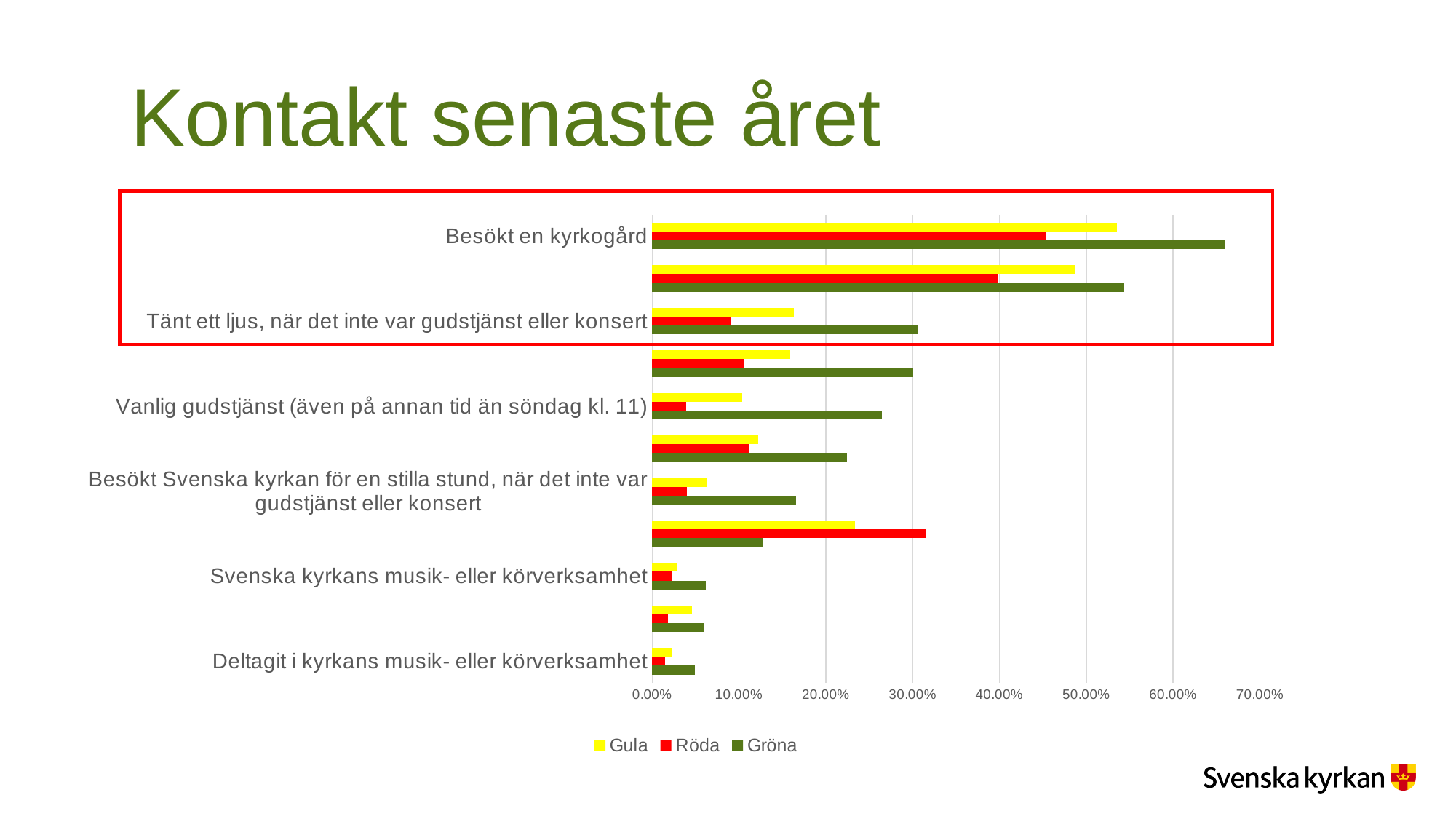
What kind of chart is shown on the slide? bar chart How many series does the legend list? 3 For 'Besökt en kyrkogård', which series has the larger value, Gula or Gröna? Gröna Is the Gula value for 'Besökt en kyrkogård' greater or less than 50.00%? greater Is the Gröna value for 'Svenska kyrkans musik- eller körverksamhet' greater or less than 10.00%? less Is the Röda value for 'Besökt en kyrkogård' greater or less than 50.00%? less Which labelled category has the highest Gröna value? Besökt en kyrkogård Which series is drawn in red in the chart? Röda What is the title of the slide containing the chart? Kontakt senaste året